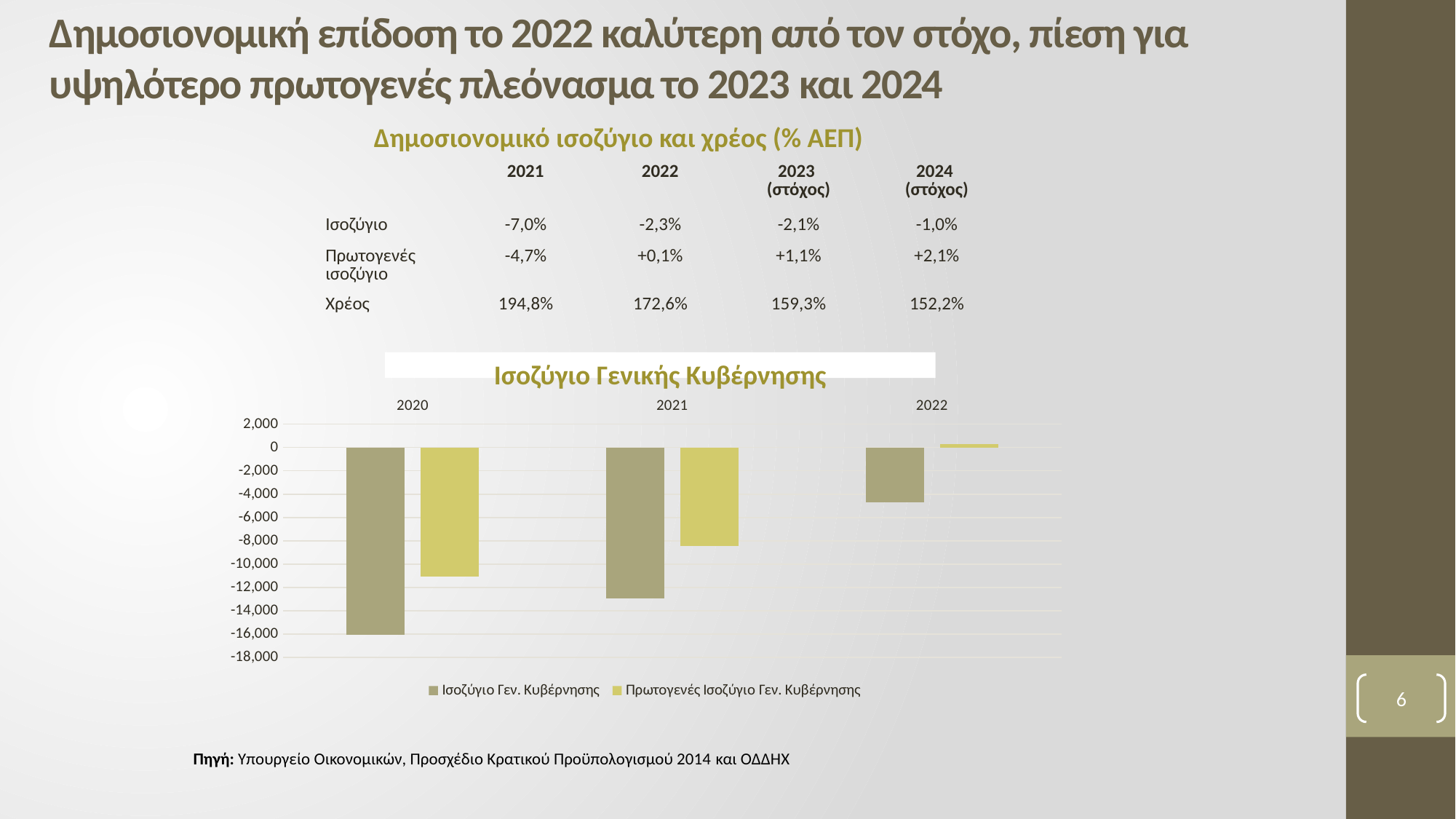
In the 'Ισοζύγιο Γενικής Κυβέρνησης' chart, which is larger in 2021: 'Ισοζύγιο Γεν. Κυβέρνησης' or 'Πρωτογενές Ισοζύγιο Γεν. Κυβέρνησης'? Πρωτογενές Ισοζύγιο Γεν. Κυβέρνησης In the 'Ισοζύγιο Γενικής Κυβέρνησης' chart, is the value for 'Πρωτογενές Ισοζύγιο Γεν. Κυβέρνησης' in 2020 greater or less than -10,000? less What is the title of the bar chart on the slide? Ισοζύγιο Γενικής Κυβέρνησης In the 'Ισοζύγιο Γενικής Κυβέρνησης' chart, is the value for 'Πρωτογενές Ισοζύγιο Γεν. Κυβέρνησης' in 2022 greater or less than 0? greater In the 'Ισοζύγιο Γενικής Κυβέρνησης' chart, do the values for 'Ισοζύγιο Γεν. Κυβέρνησης' rise or fall from 2020 to 2022? rise How many years are shown on the x axis of the 'Ισοζύγιο Γενικής Κυβέρνησης' chart? 3 In the 'Ισοζύγιο Γενικής Κυβέρνησης' chart, is the value for 'Ισοζύγιο Γεν. Κυβέρνησης' in 2021 greater or less than -12,000? less What kind of chart is the 'Ισοζύγιο Γενικής Κυβέρνησης' chart? bar chart How many series does the legend of the 'Ισοζύγιο Γενικής Κυβέρνησης' chart list? 2 In the 'Ισοζύγιο Γενικής Κυβέρνησης' chart, which year has the highest value for 'Πρωτογενές Ισοζύγιο Γεν. Κυβέρνησης'? 2022 In the 'Ισοζύγιο Γενικής Κυβέρνησης' chart, which year has the lowest value for 'Ισοζύγιο Γεν. Κυβέρνησης'? 2020